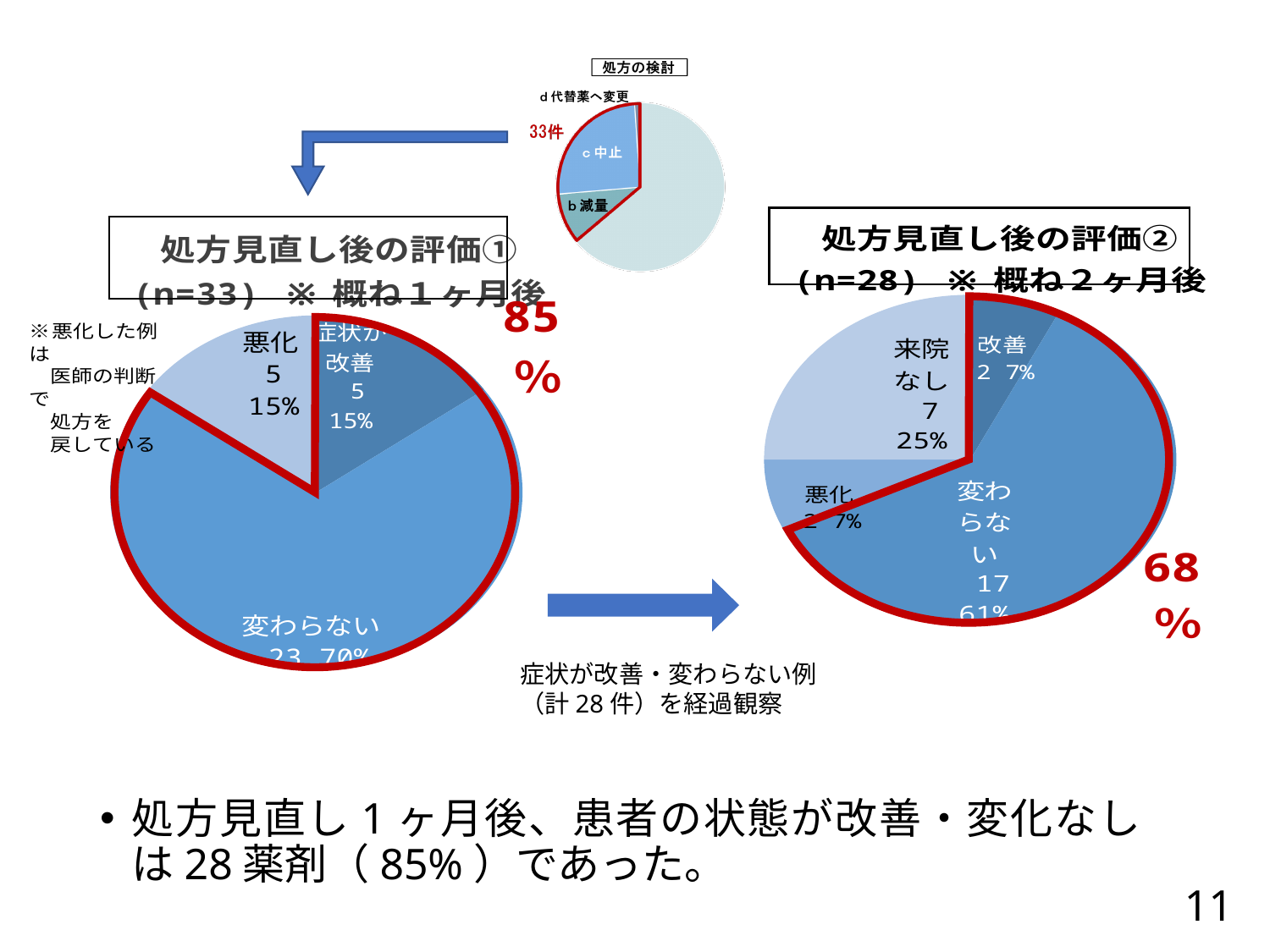
In the 処方見直し後の評価② (n=28) pie chart, which category has the largest share? 変わらない What is the title of the small pie chart at the top of the slide? 処方の検討 In the 処方見直し後の評価① (n=33) pie chart, how many cases are 悪化? 5 How many slices does the 処方見直し後の評価① (n=33) pie chart have? 3 In the 処方見直し後の評価② (n=28) pie chart, which is larger, 来院なし or 改善? 来院なし In the 処方見直し後の評価① (n=33) pie chart, what percentage is 変わらない? 70% In the 処方見直し後の評価① (n=33) pie chart, what is the difference in cases between 変わらない and 悪化? 18 How many slices does the 処方見直し後の評価② (n=28) pie chart have? 4 What kind of chart is 処方見直し後の評価① (n=33)? pie chart In the 処方見直し後の評価① (n=33) pie chart, which category has the largest share? 変わらない In the 処方見直し後の評価② (n=28) pie chart, how many cases are 変わらない? 17 In the 処方見直し後の評価② (n=28) pie chart, what percentage is 来院なし? 25%